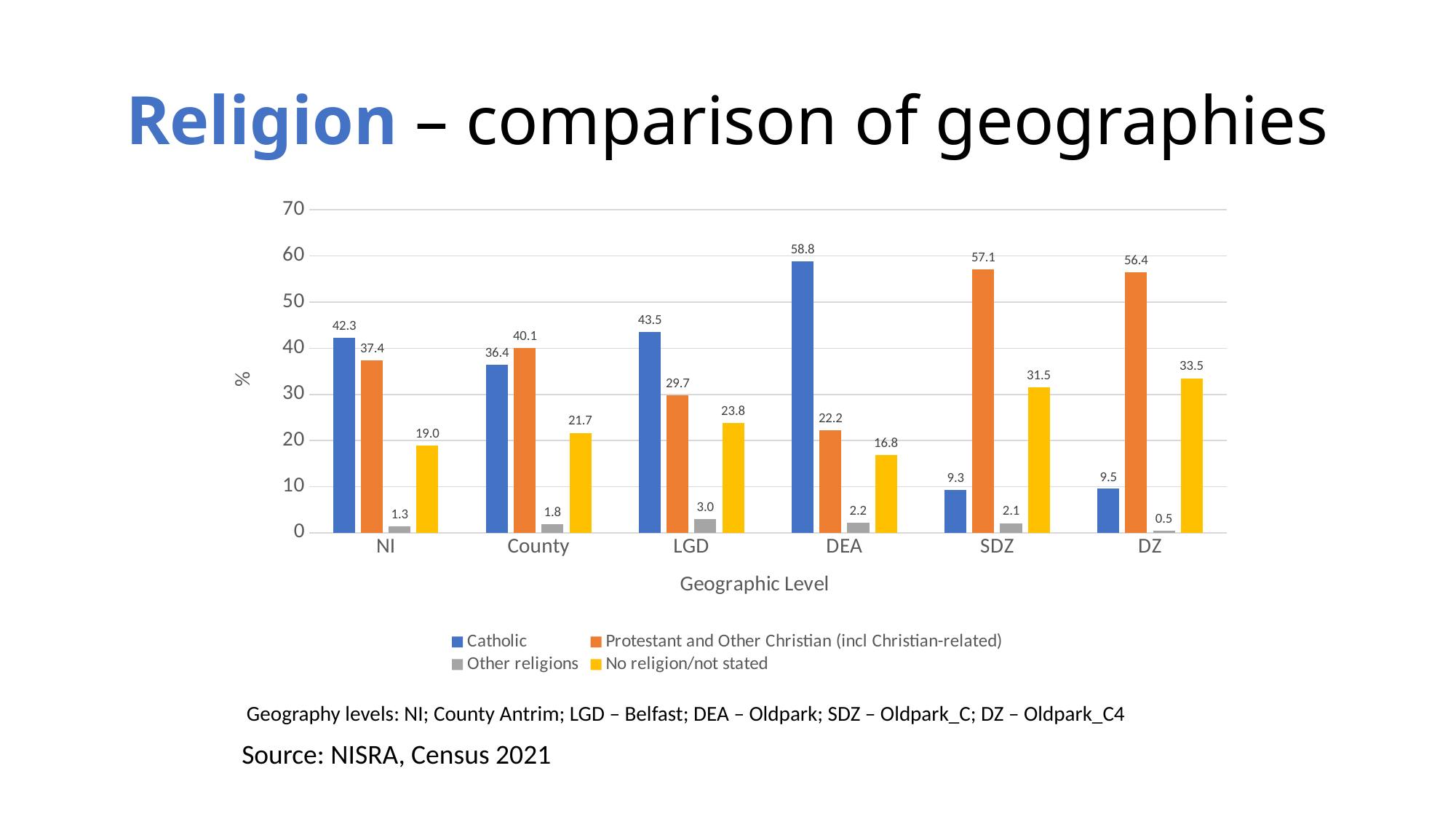
What is the Other religions value for DZ? 0.5 How many series does the legend list? 4 What is the value for Protestant and Other Christian (incl Christian-related) at SDZ? 57.1 What is the difference between the Catholic value and the Protestant and Other Christian value at LGD? 13.8 What kind of chart is shown on the slide? Bar chart Which geographic level has the lowest Protestant and Other Christian (incl Christian-related) value? DEA What is the No religion/not stated value for NI? 19.0 How many geographic levels are shown on the x axis? 6 What is the Catholic value for DEA? 58.8 Which geographic level has the highest Catholic value? DEA Which is larger at County: the Catholic value or the Protestant and Other Christian value? Protestant and Other Christian Is the No religion/not stated value for DZ greater or less than 30? greater